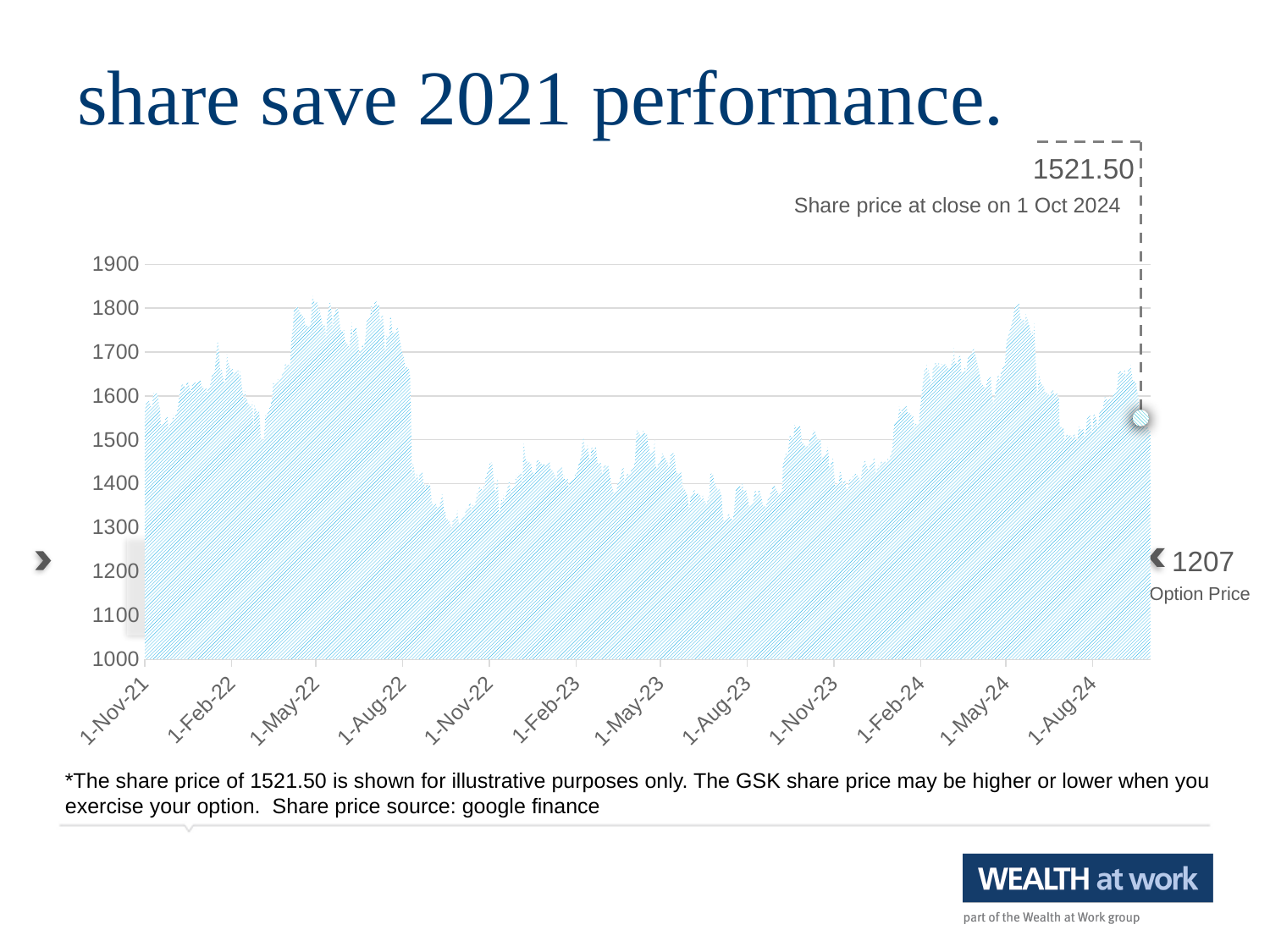
What share price at close on 1 Oct 2024 is shown on the chart? 1521.50 What is the difference between the share price at close on 1 Oct 2024 (1521.50) and the option price (1207)? 314.50 How many date labels are shown along the x axis? 12 What is the option price marked on the chart? 1207 Is the share price at 1-May-22 greater or less than 1500? greater Does the share price rise or fall between 1-May-22 and 1-Nov-22? Fall What kind of chart is shown on the slide? Area chart Is the lowest share price shown on the chart greater or less than 1400? less What is the highest value shown on the y axis? 1900 Is the share price at 1-Nov-21 greater or less than 1400? greater What is the source of the share price data stated on the slide? google finance Which is larger: the share price at close on 1 Oct 2024 or the option price? Share price at close on 1 Oct 2024 (1521.50)